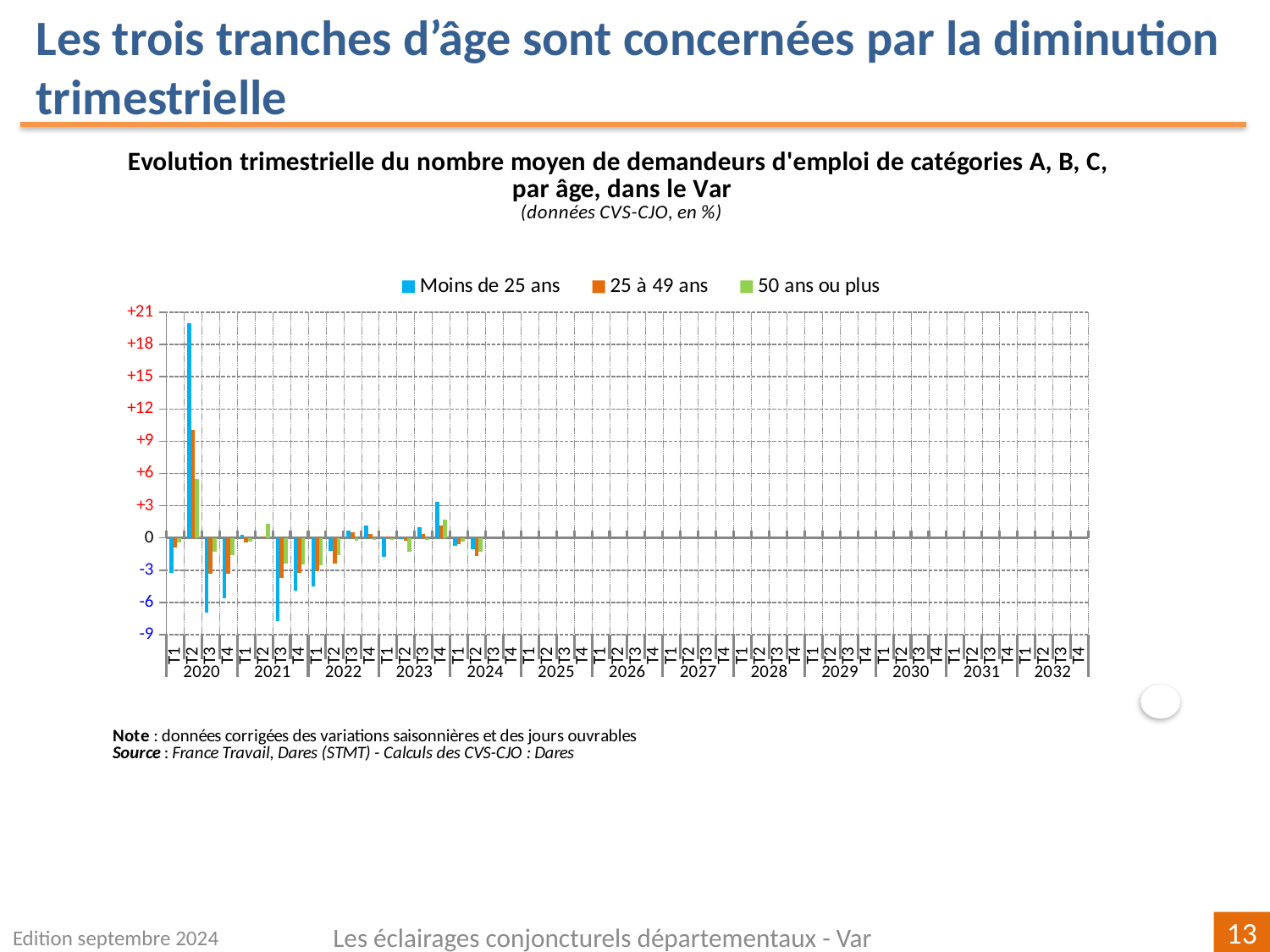
What is the highest tick value shown on the vertical axis? +21 Is the value for Moins de 25 ans in T2 2020 greater or less than +18? greater What kind of chart is shown on the slide? bar chart Which age groups are listed in the legend? Moins de 25 ans, 25 à 49 ans, 50 ans ou plus In T2 2020, which is larger: the value for Moins de 25 ans or the value for 25 à 49 ans? Moins de 25 ans How many years are labelled along the x axis? 13 Is the value for 25 à 49 ans in T2 2020 greater or less than +9? greater Is the value for 50 ans ou plus in T2 2020 greater or less than +6? less In which quarter does the Moins de 25 ans series reach its highest value? T2 2020 Which series has the highest bar in the whole chart? Moins de 25 ans How many series does the legend list? 3